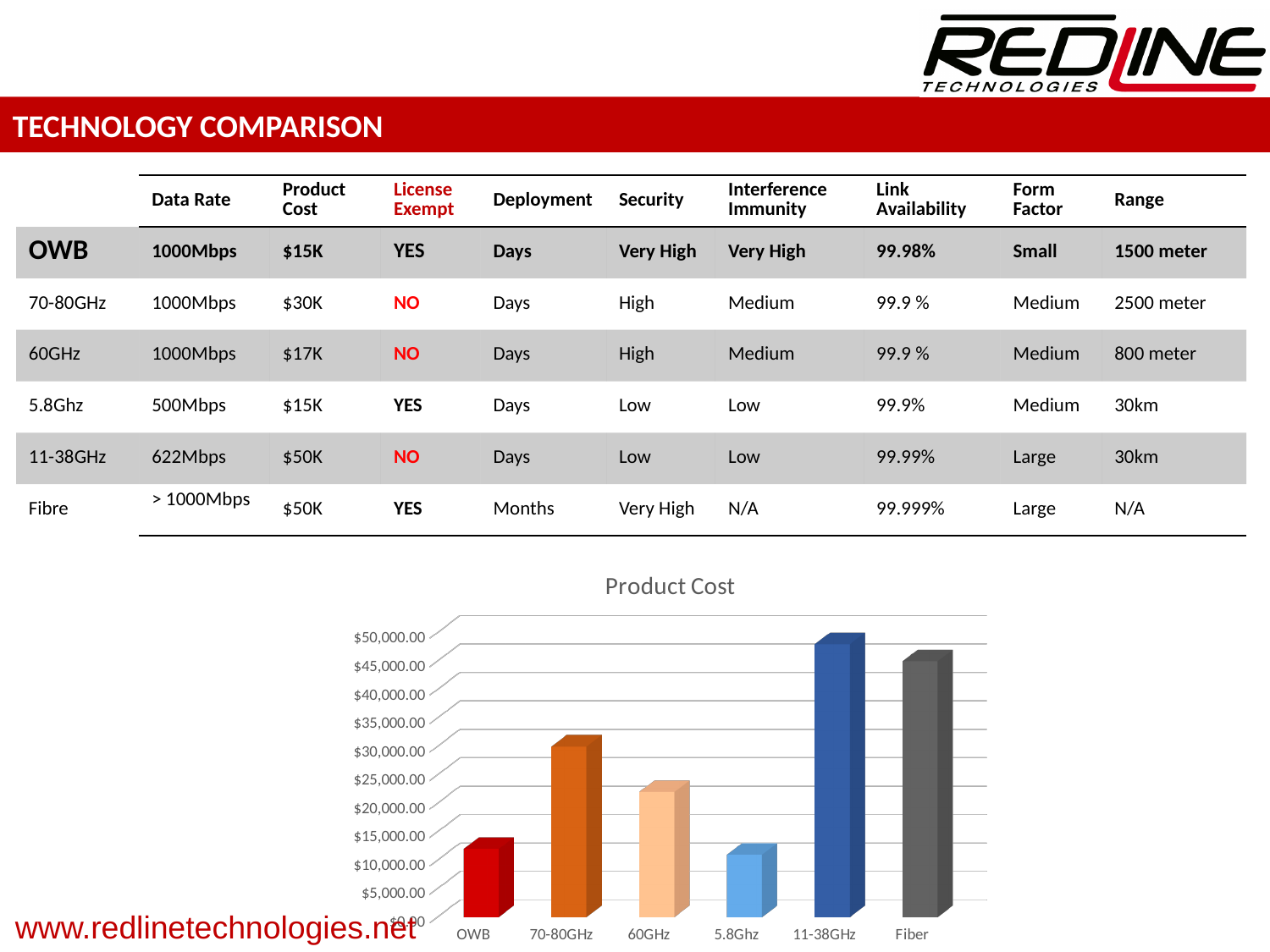
In the Product Cost chart, which has the larger value, 11-38GHz or OWB? 11-38GHz What kind of chart is shown on the slide? bar chart In the Product Cost chart, is the value for 5.8Ghz greater or less than $20,000.00? less What colour is the OWB bar in the Product Cost chart? red In the Product Cost chart, is the value for 70-80GHz greater or less than $25,000.00? greater How many categories are plotted in the Product Cost chart? 6 In the Product Cost chart, is the value for Fiber greater or less than $35,000.00? greater In the Product Cost chart, which has the larger value, 70-80GHz or 5.8Ghz? 70-80GHz What is the title of the chart? Product Cost